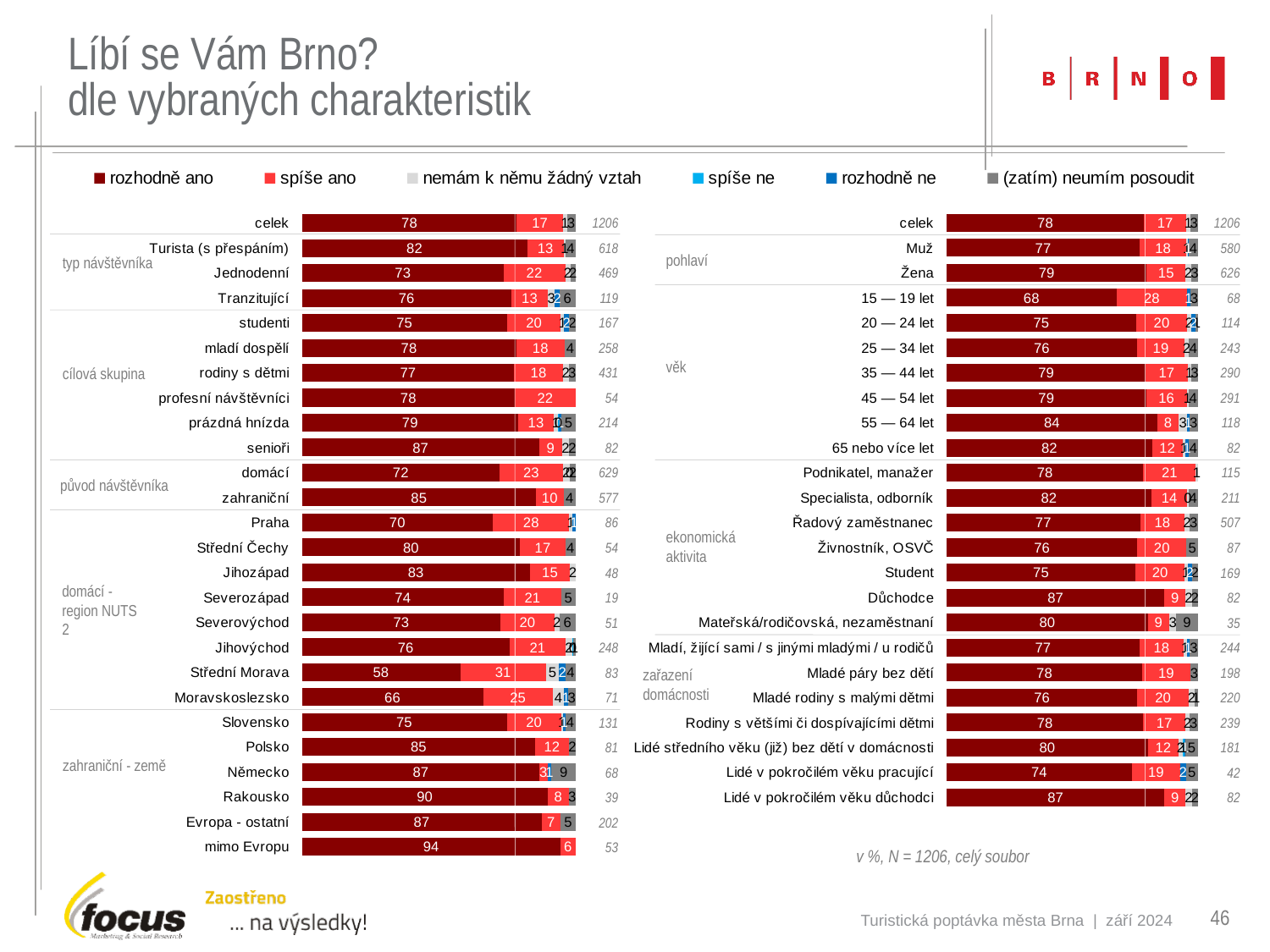
In the left chart, what is the difference between the 'rozhodně ano' values for 'Turista (s přespáním)' and 'Jednodenní'? 9 In the left chart, which category has the highest 'rozhodně ano' value? mimo Evropu In the left chart, what is the 'spíše ano' value for 'Střední Morava'? 31 In the right chart, which has a higher 'rozhodně ano' value, 'Muž' or 'Žena'? Žena How many series does the legend list? 6 What kind of chart is shown on the slide? Stacked bar chart In the right chart, which age group has the lowest 'rozhodně ano' value? 15 — 19 let In the right chart, what is the 'rozhodně ano' value for 'Důchodce'? 87 In the right chart, what is the 'spíše ano' value for '15 — 19 let'? 28 In the left chart, what is the 'rozhodně ano' value for 'mimo Evropu'? 94 In the right chart, what is the 'rozhodně ano' value for '15 — 19 let'? 68 In the left chart, which category has the lowest 'rozhodně ano' value? Střední Morava